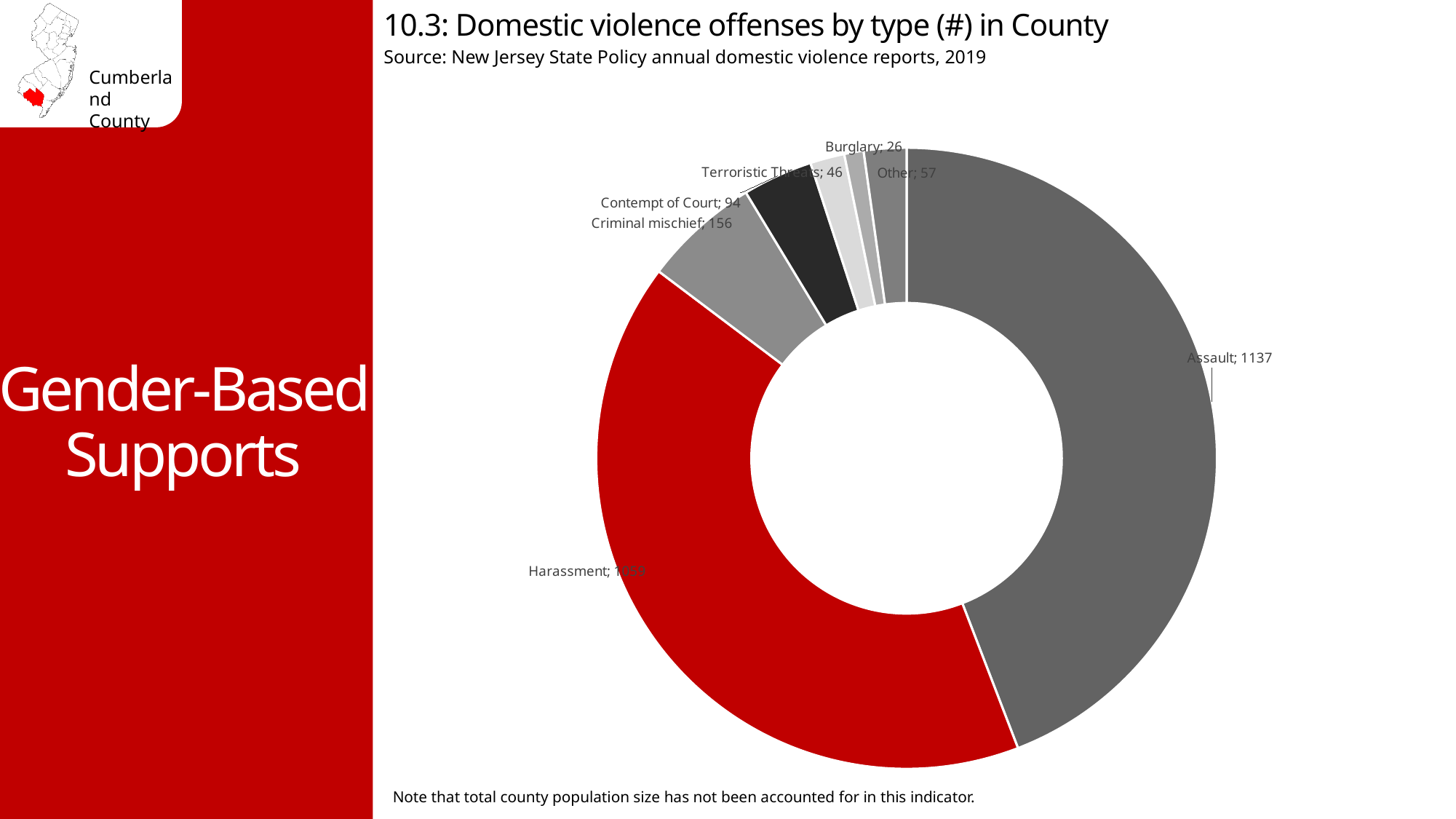
Which offense type has the smallest slice? Burglary What is the difference between Criminal mischief and Contempt of Court? 62 What is the value for Assault? 1137 What is the title of the chart? 10.3: Domestic violence offenses by type (#) in County Which is larger, Terroristic Threats or Burglary? Terroristic Threats How many offense types are shown in the chart? 7 What is the value for Burglary? 26 What is the value for Other? 57 What is the value for Contempt of Court? 94 What is the value for Criminal mischief? 156 Which offense type has the largest slice? Assault What kind of chart is shown on the slide? Doughnut (pie) chart